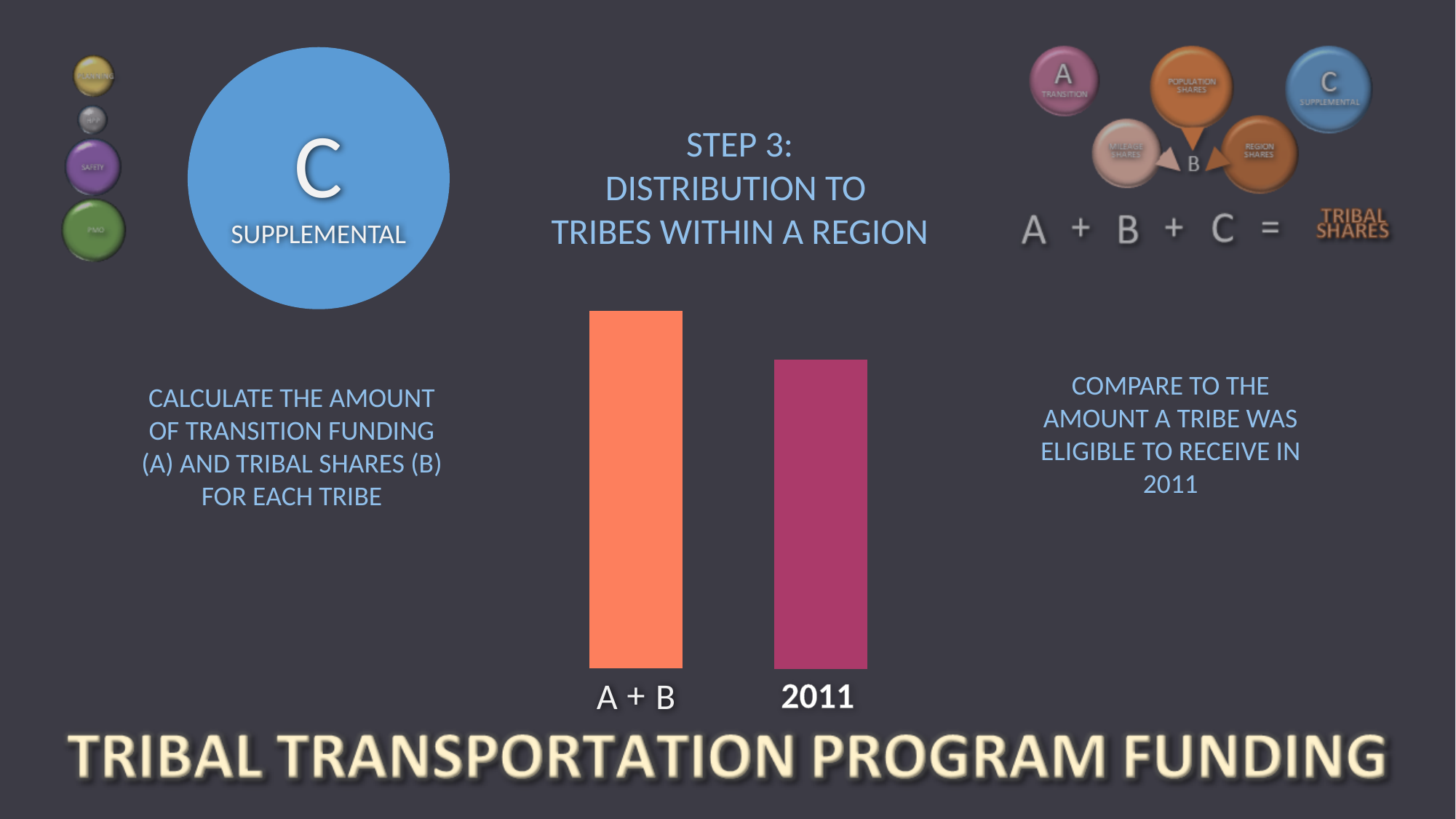
How many bars does the chart show? 2 Which category has the lowest bar? 2011 Is the bar for 2011 shorter or taller than the bar for A + B? shorter Which bar is taller, A + B or 2011? A + B What kind of chart is shown in the centre of the slide? bar chart Which category has the highest bar? A + B What are the labels of the two bars in the chart? A + B and 2011 What colour is the A + B bar? orange